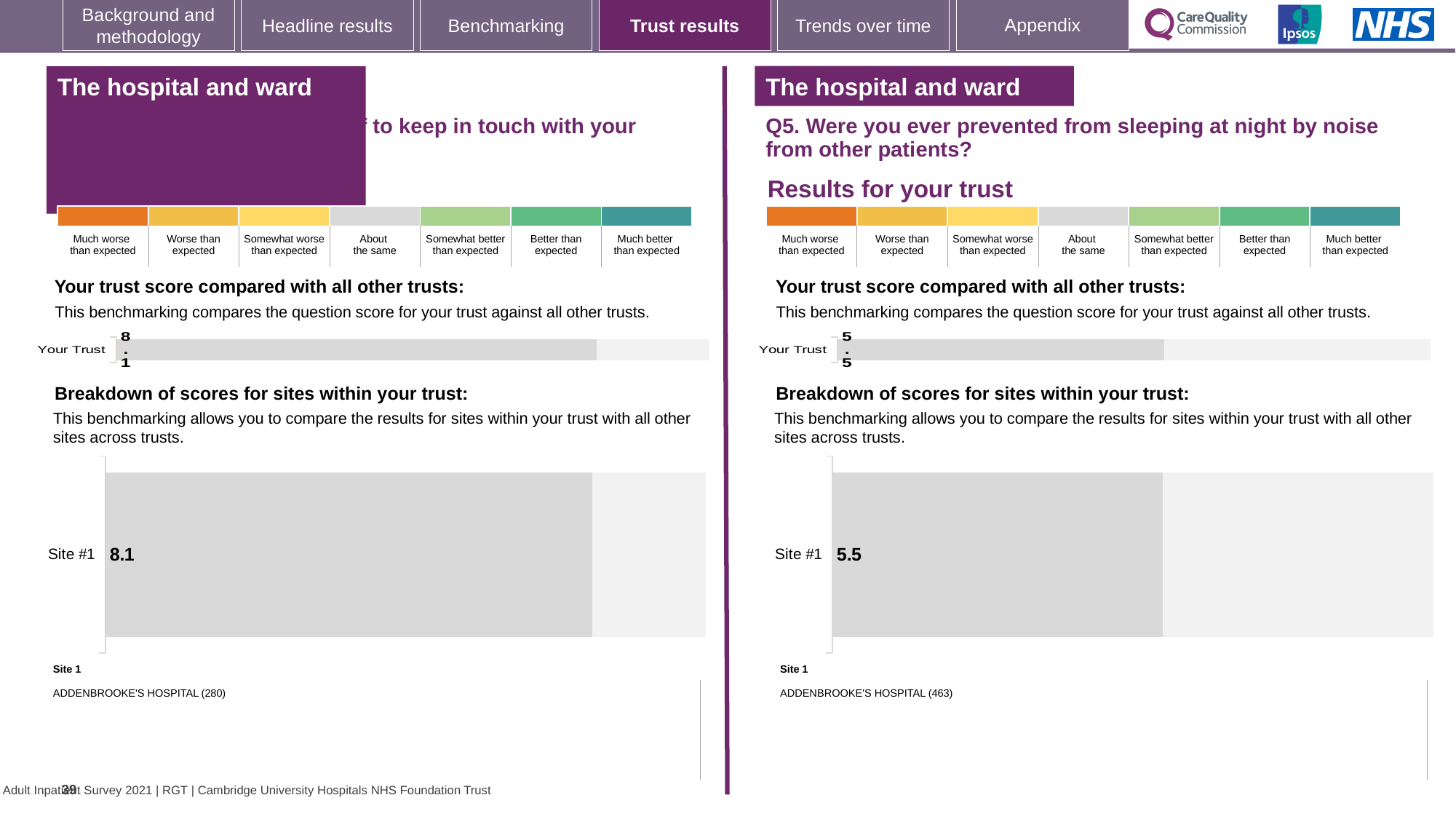
Which is larger: the Site #1 score on the left-hand chart or the Site #1 score on the right-hand chart (Q5)? Left-hand chart (8.1) On the right-hand side of the slide (Q5, prevented from sleeping at night by noise from other patients), what is the score shown for Your Trust? 5.5 On the left-hand side, which site is listed as Site 1 below the breakdown chart? ADDENBROOKE'S HOSPITAL (280) On the right-hand side (Q5), which site is listed as Site 1 below the breakdown chart? ADDENBROOKE'S HOSPITAL (463) On the right-hand side (Q5), is the Your Trust score greater or less than the Site #1 score, or are they equal? Equal On the right-hand side of the slide (Q5), what score is shown for Site #1 in the breakdown of scores for sites within your trust? 5.5 How many sites are shown in the breakdown of scores for sites within your trust on the right-hand side (Q5)? 1 What kind of chart is used to show the Site #1 score on the right-hand side (Q5)? Bar chart On the left-hand side of the slide, what score is shown for Site #1 in the breakdown of scores for sites within your trust? 8.1 What is the difference between the Site #1 score on the left-hand chart (8.1) and the Site #1 score on the right-hand chart (5.5)? 2.6 On the left-hand side of the slide, what is the score shown for Your Trust? 8.1